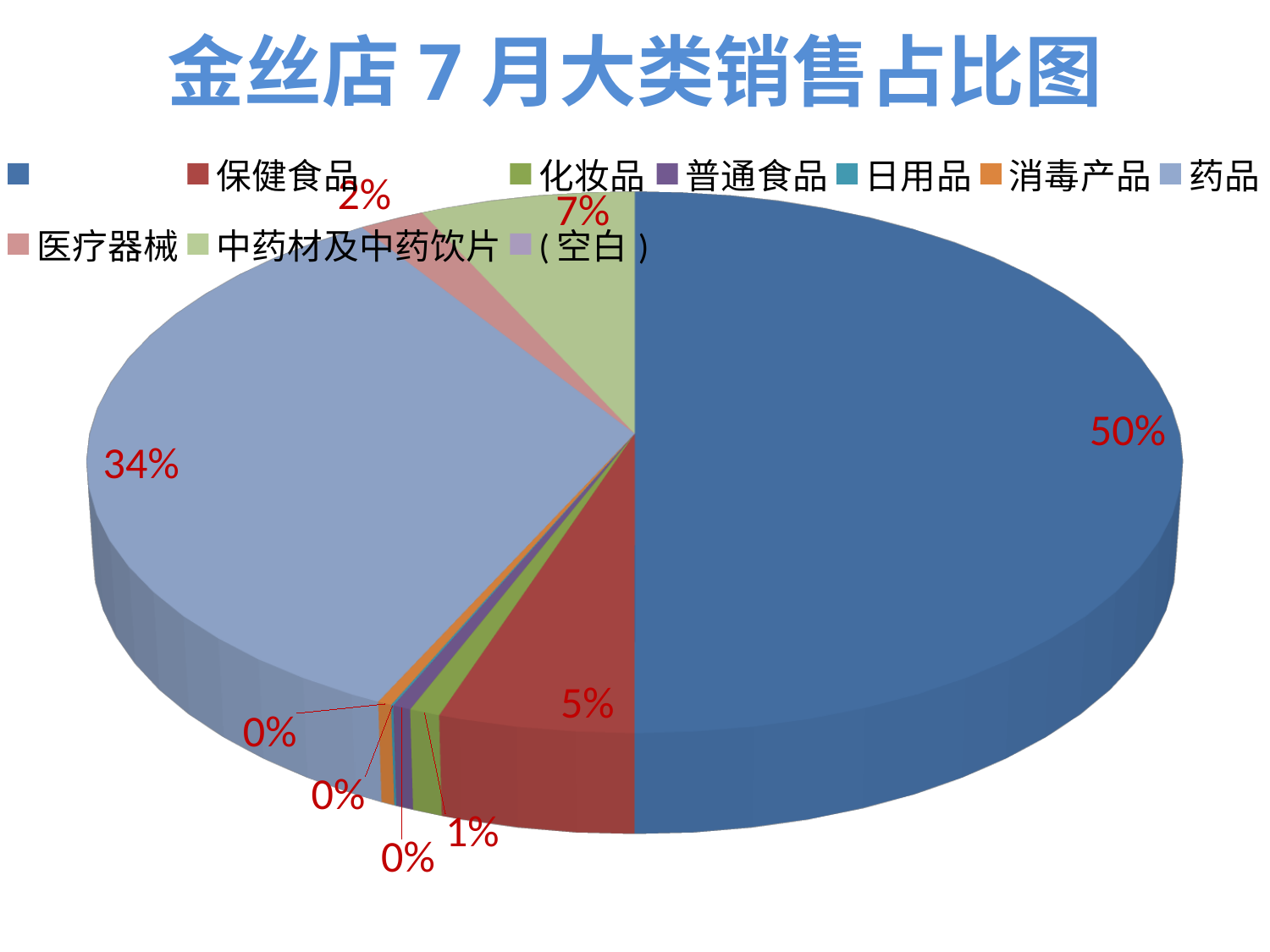
Which has the larger share, 药品 or 保健食品? 药品 What is the title of the chart? 金丝店7月大类销售占比图 What percentage is shown for 化妆品? 1% What kind of chart is shown on the slide? Pie chart How many entries does the legend list? 10 What share of sales does 药品 account for in the pie chart? 34% What is the difference in percentage points between the 药品 share and the 中药材及中药饮片 share? 27% What percentage is shown for 中药材及中药饮片? 7% What percentage is shown for 普通食品? 0% What percentage is shown for 医疗器械? 2% What percentage is shown for 保健食品? 5% Which has the larger share, 中药材及中药饮片 or 医疗器械? 中药材及中药饮片